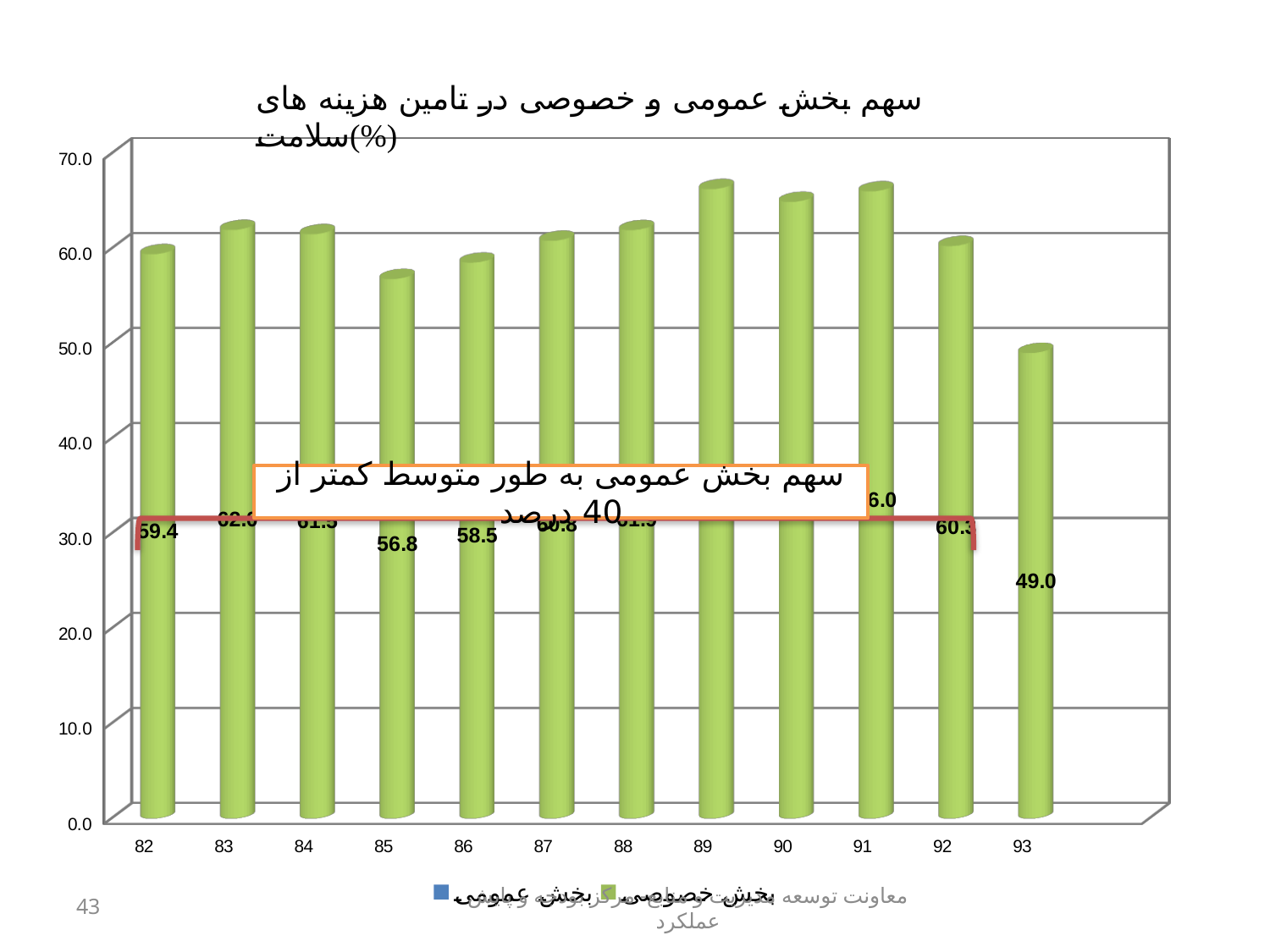
What is the value for 82? 59.4 How many categories are shown on the x axis? 12 What is the value for 92? 60.3 What kind of chart is shown on the slide? bar chart Which category has the lowest value? 93 What is the value for 85? 56.8 Is the value for 89 greater or less than 60.0? greater What is the value for 93? 49.0 Which is larger, the value for 82 or the value for 85? 82 What is the difference between the values for 82 and 93? 10.4 How many series does the legend list? 2 What is the difference between the values for 86 and 85? 1.7